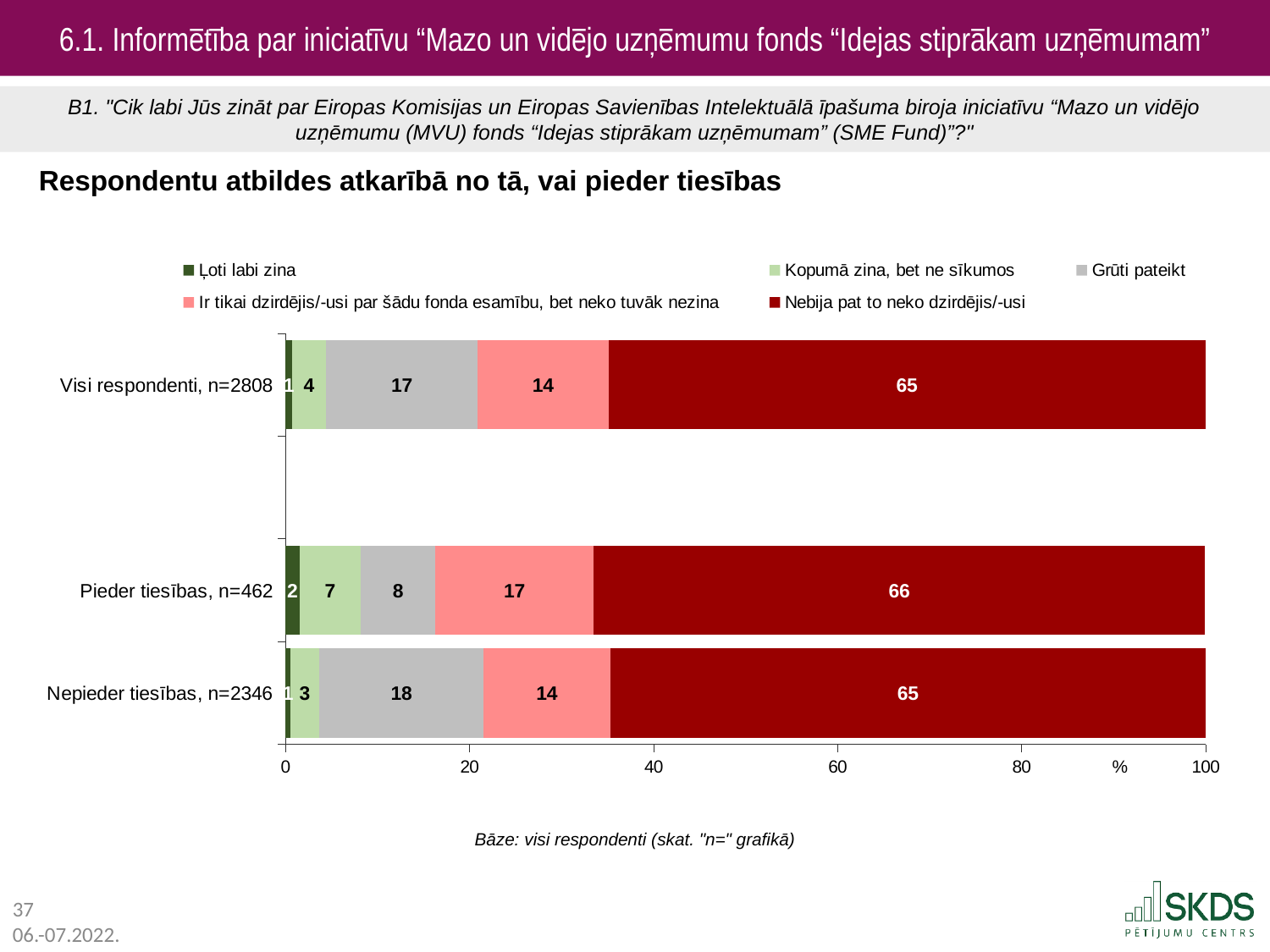
Which respondent group has the lowest value for "Grūti pateikt"? Pieder tiesības, n=462 What is the value for "Nebija pat to neko dzirdējis/-usi" in the "Pieder tiesības, n=462" bar? 66 What kind of chart is shown on the slide? stacked bar chart What is the value for "Kopumā zina, bet ne sīkumos" in the "Nepieder tiesības, n=2346" bar? 3 Which respondent group has the highest value for "Kopumā zina, bet ne sīkumos"? Pieder tiesības, n=462 What is the difference between the "Grūti pateikt" values for "Nepieder tiesības, n=2346" and "Pieder tiesības, n=462"? 10 What is the value for "Ir tikai dzirdējis/-usi par šādu fonda esamību, bet neko tuvāk nezina" in the "Pieder tiesības, n=462" bar? 17 How many respondent groups (bars) are shown in the chart? 3 Which is larger: the "Ļoti labi zina" value for "Pieder tiesības, n=462" or for "Nepieder tiesības, n=2346"? Pieder tiesības, n=462 How many series does the legend list? 5 What is the value for "Grūti pateikt" in the "Visi respondenti, n=2808" bar? 17 What is the total of the "Pieder tiesības, n=462" stacked bar? 100